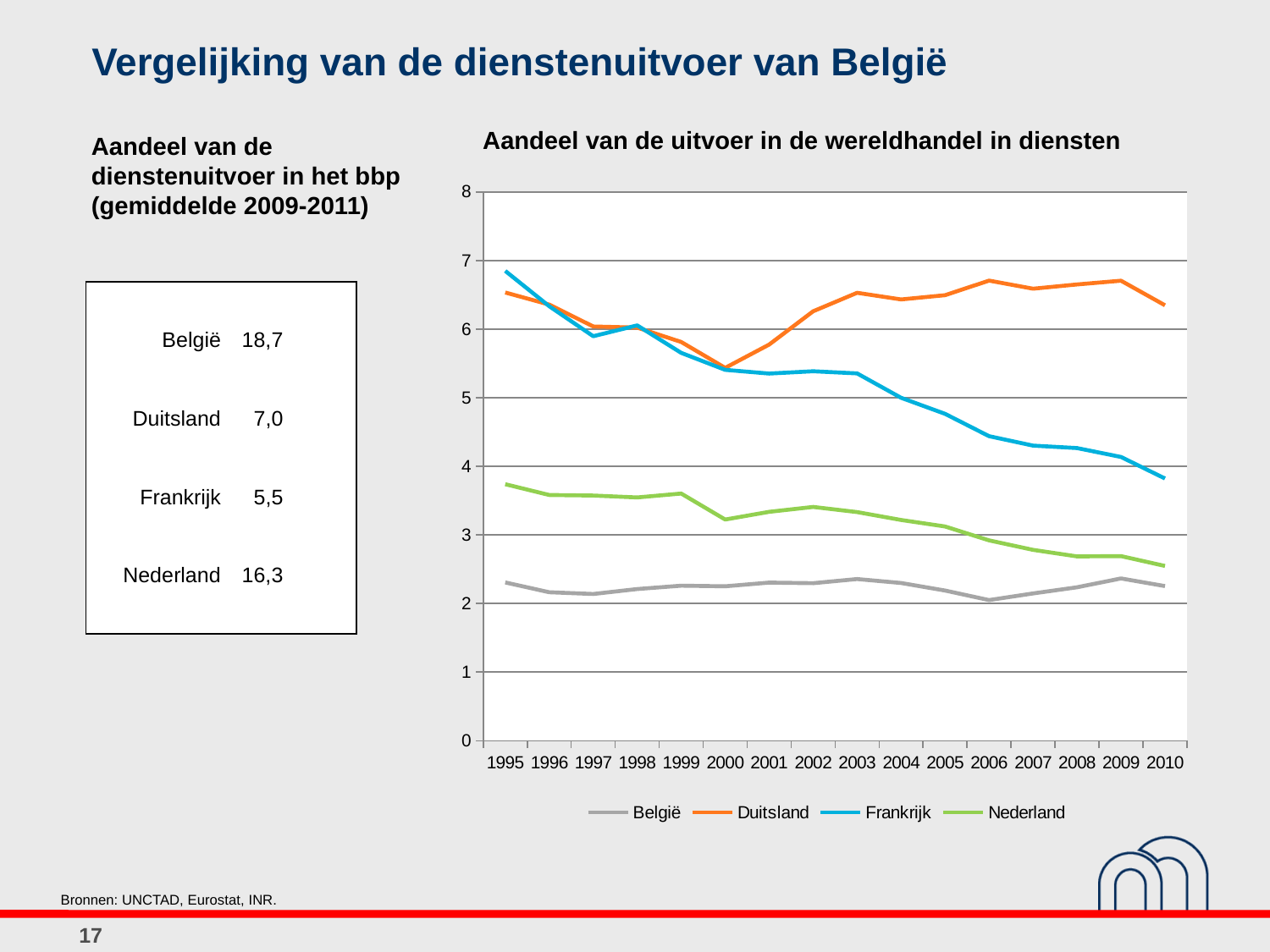
In the line chart, does the value for Nederland rise or fall from 1995 to 2010? fall In the line chart, does the value for Frankrijk rise or fall from 1995 to 2010? fall In the line chart, is the value for Frankrijk in 1995 greater or less than 6? greater In the line chart, which colour is used for the Duitsland series? orange In the line chart, is the value for Nederland in 2010 greater or less than 3? less What kind of chart is shown under the title 'Aandeel van de uitvoer in de wereldhandel in diensten'? line chart In the line chart, which country has the highest value in 2010? Duitsland In the line chart, which is larger in 2000: the value for Nederland or the value for België? Nederland In the line chart, which country has the highest value in 1995? Frankrijk How many series does the legend of the line chart list? 4 How many years are shown on the x axis of the line chart? 16 In the line chart, which country has the lowest value in 2010? België